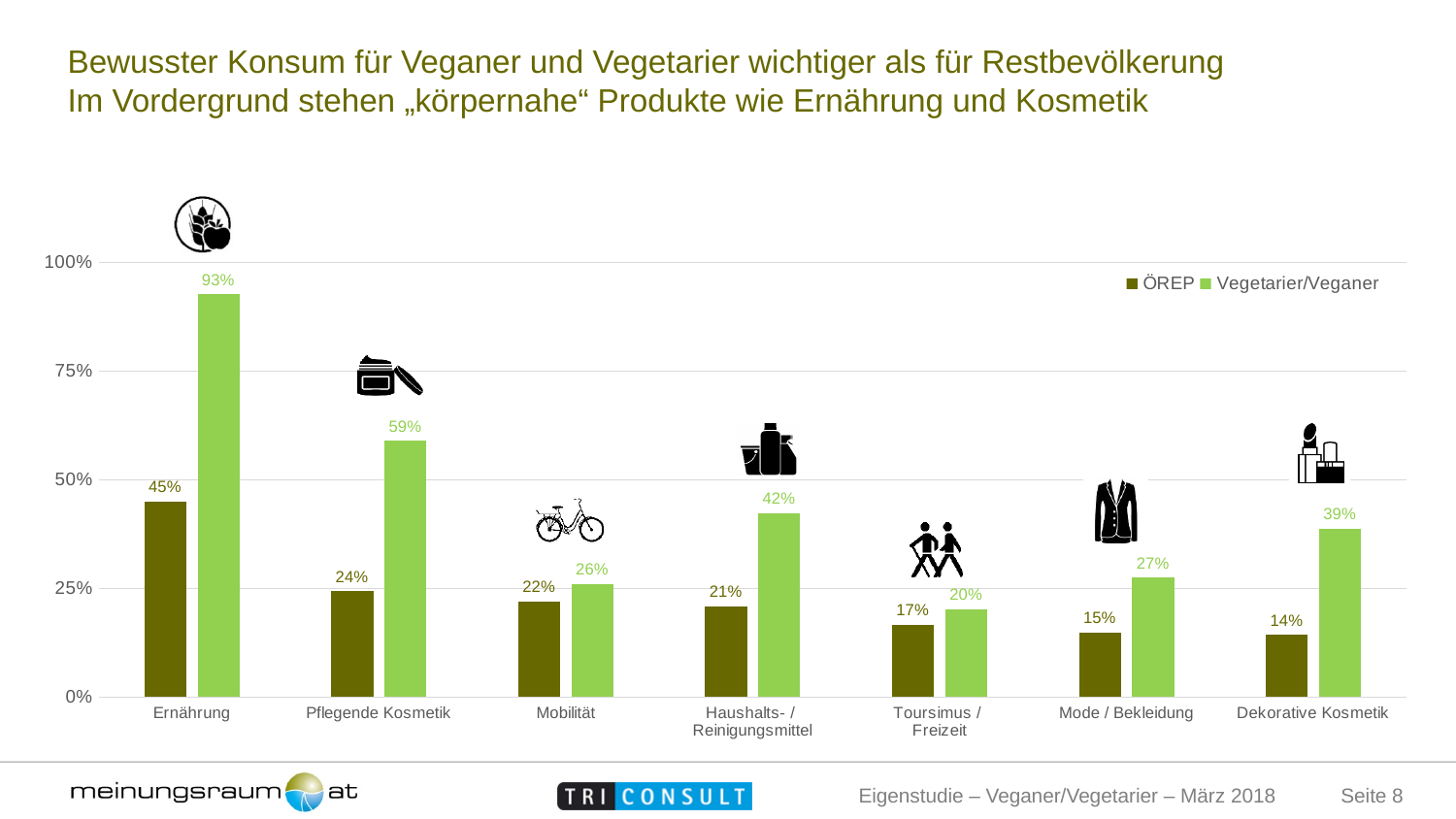
Which series is shown in light green in the legend? Vegetarier/Veganer What is the Vegetarier/Veganer value for Ernährung? 93% How many categories are shown on the x axis? 7 What is the difference between the Vegetarier/Veganer and ÖREP values for Ernährung? 48% Which category has the highest ÖREP value? Ernährung How many series does the legend list? 2 What is the Vegetarier/Veganer value for Dekorative Kosmetik? 39% What is the ÖREP value for Pflegende Kosmetik? 24% What kind of chart is shown on the slide? Bar chart Do the ÖREP values rise or fall from left to right along the x axis? Fall Which is larger for Haushalts- / Reinigungsmittel: the ÖREP value or the Vegetarier/Veganer value? Vegetarier/Veganer Which category has the lowest Vegetarier/Veganer value? Toursimus / Freizeit